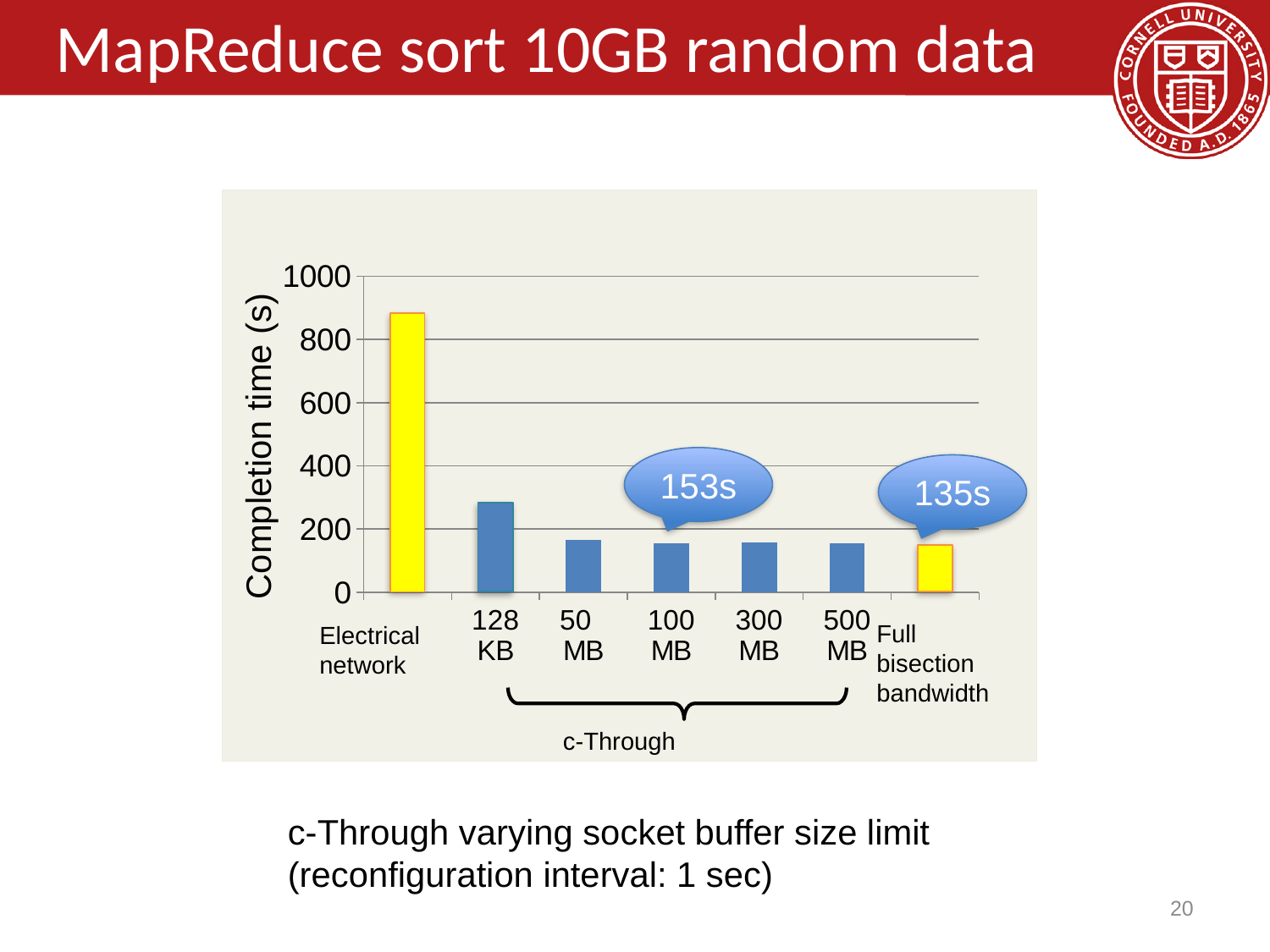
Which category has the lowest completion time? Full bisection bandwidth Is the completion time for 128 KB greater or less than 200? greater What is the completion time for the 100 MB socket buffer size? 153s What is the completion time for Full bisection bandwidth? 135s What is the difference between the completion time for 100 MB and for Full bisection bandwidth? 18s How many categories are plotted along the x axis? 7 Which has a larger completion time, Electrical network or 128 KB? Electrical network Is the completion time for 50 MB greater or less than 400? less Is the completion time for Electrical network greater or less than 800? greater Which category has the highest completion time? Electrical network What is the label on the y axis of the chart? Completion time (s) What kind of chart is shown on the slide? bar chart